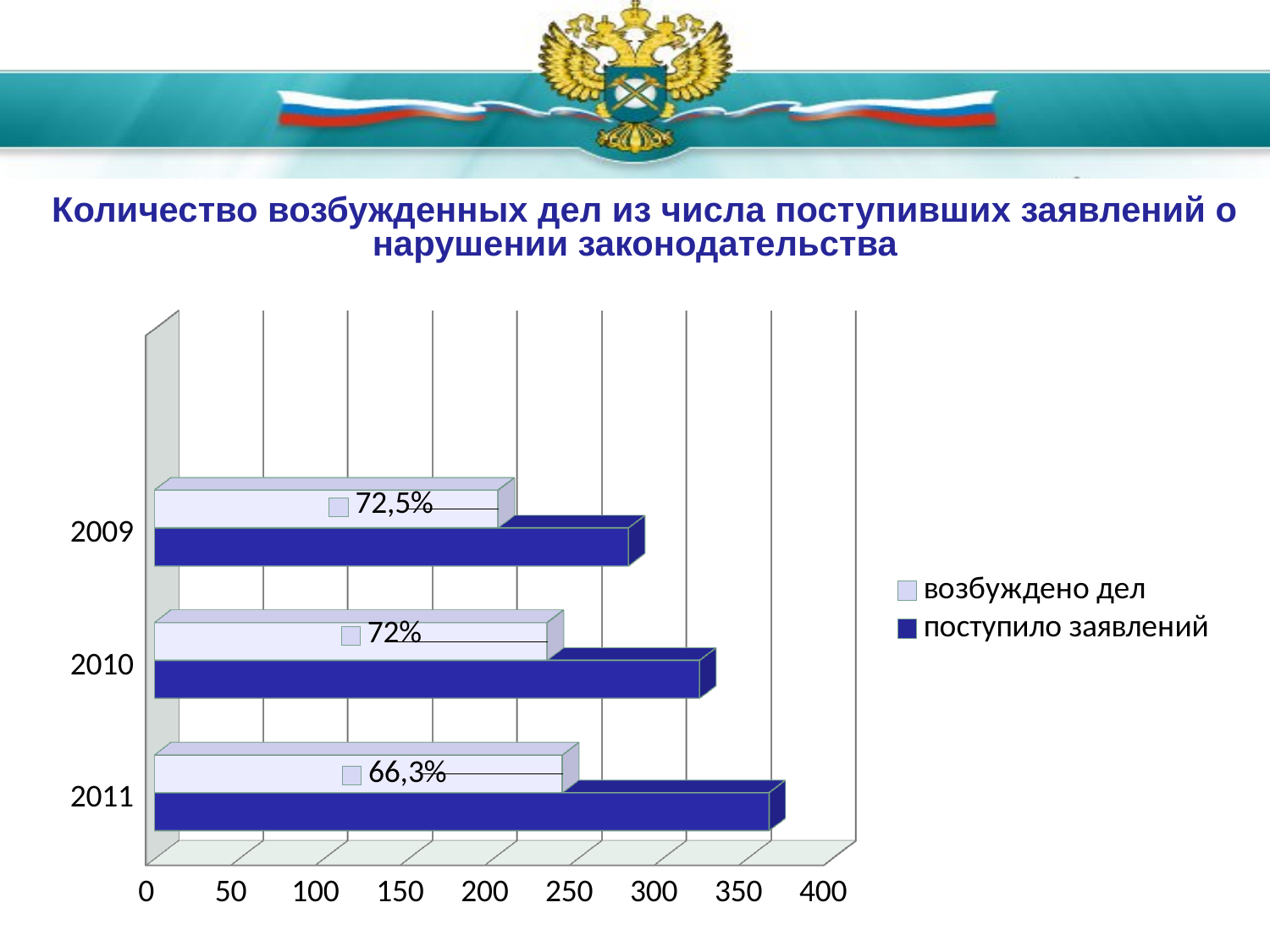
How many years (categories) are shown on the chart? 3 In which year is the 'поступило заявлений' bar the longest? 2011 Do the 'поступило заявлений' values rise or fall from 2009 to 2011? rise Is the value for 'поступило заявлений' in 2011 greater or less than 350? greater Which is larger: 'возбуждено дел' in 2011 or 'возбуждено дел' in 2009? 2011 How many series does the legend list? 2 What percentage label is shown on the 'возбуждено дел' bar for 2011? 66,3% What percentage label is shown on the 'возбуждено дел' bar for 2010? 72% What percentage label is shown on the 'возбуждено дел' bar for 2009? 72,5% Is the value for 'поступило заявлений' in 2009 greater or less than 300? less In which year is the 'поступило заявлений' bar the shortest? 2009 What kind of chart is shown on the slide? bar chart